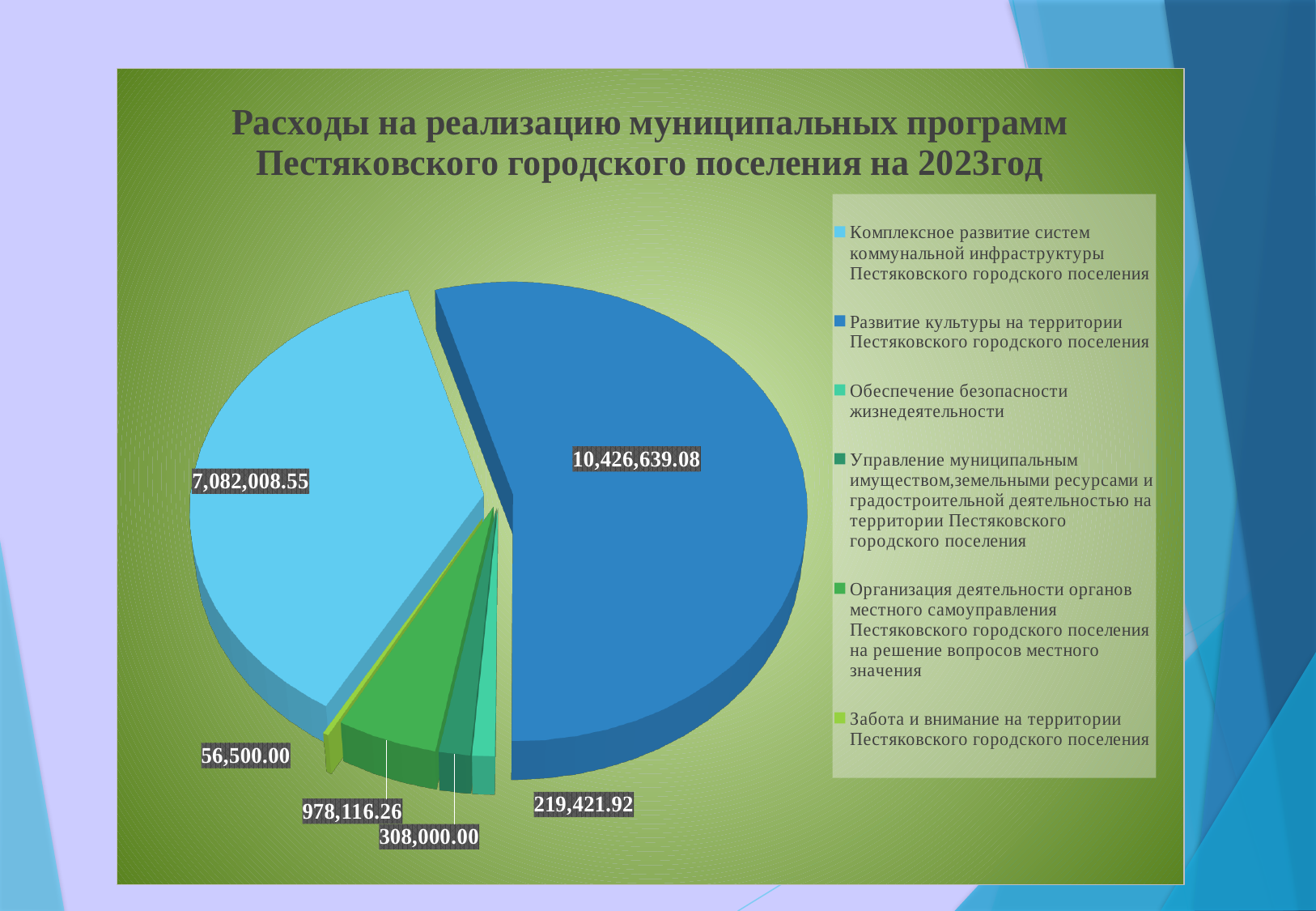
Which program has the smallest expenditure in the pie chart? Забота и внимание на территории Пестяковского городского поселения How many entries does the legend list? 6 What is the difference between the two largest slices, 10,426,639.08 and 7,082,008.55? 3,344,630.53 Which program has the largest expenditure in the pie chart? Развитие культуры на территории Пестяковского городского поселения What is the expenditure for 'Организация деятельности органов местного самоуправления Пестяковского городского поселения на решение вопросов местного значения'? 978,116.26 What type of chart is shown on the slide? Pie chart What is the value of the smallest slice of the pie chart? 56,500.00 Which is larger: the slice labelled 308,000.00 or the slice labelled 219,421.92? 308,000.00 What year does the chart title say the expenditures are for? 2023 How many slices does the pie chart have? 6 What is the value of the largest slice of the pie chart? 10,426,639.08 What is the expenditure for 'Комплексное развитие систем коммунальной инфраструктуры Пестяковского городского поселения'? 7,082,008.55